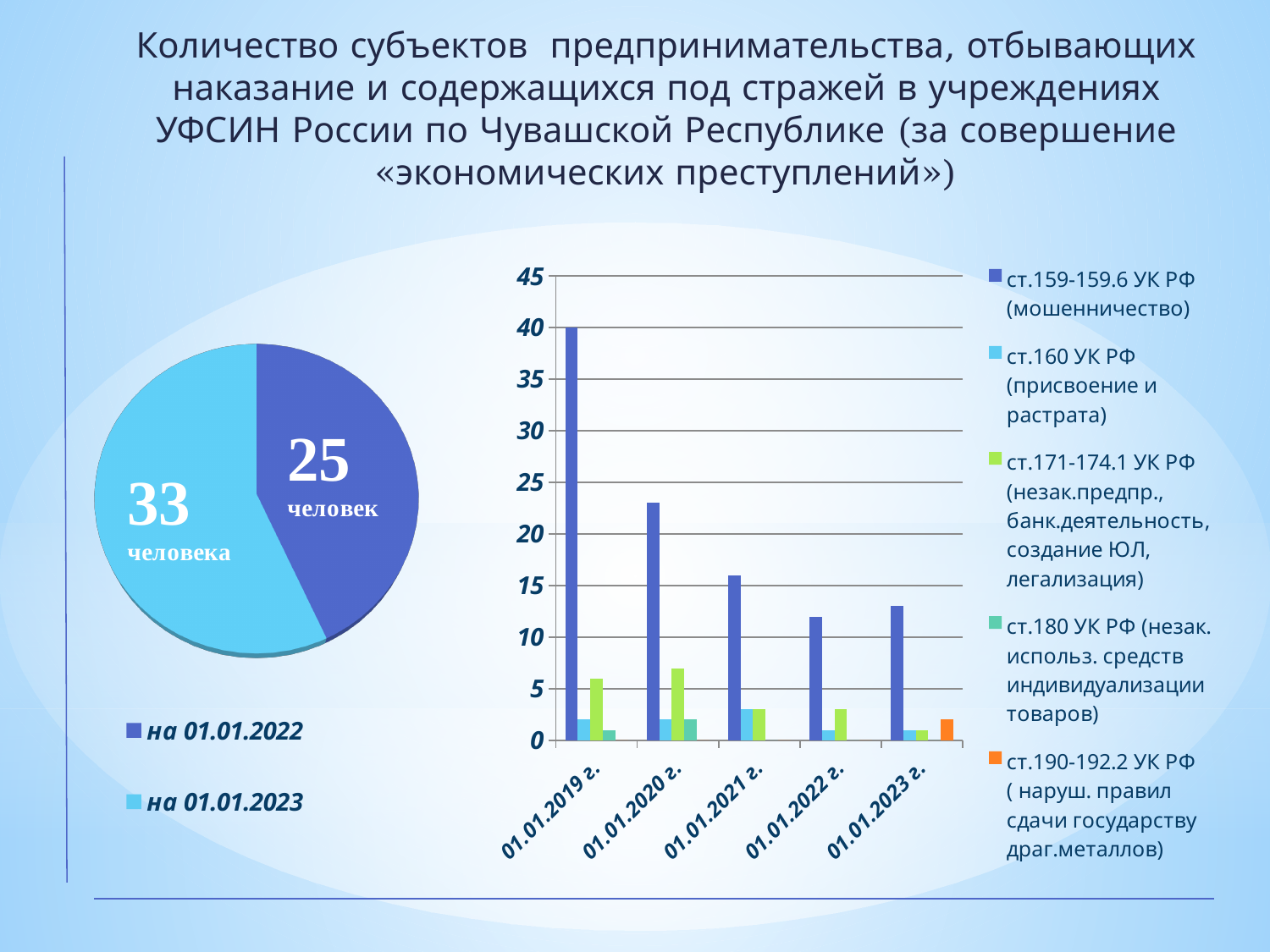
How many date categories are shown on the x axis of the bar chart on the right? 5 What kind of chart is the chart on the left side of the slide? pie chart In the pie chart on the left, what value is shown for the slice 'на 01.01.2022'? 25 человек In the bar chart on the right, is the value for 'ст.159-159.6 УК РФ (мошенничество)' at 01.01.2021 г. greater or less than 20? less How many slices does the pie chart on the left have? 2 What kind of chart is the chart on the right side of the slide? bar chart In the bar chart on the right, for which date is the value of 'ст.159-159.6 УК РФ (мошенничество)' the highest? 01.01.2019 г. In the pie chart on the left, what value is shown for the slice 'на 01.01.2023'? 33 человека How many series does the legend of the bar chart on the right list? 5 In the pie chart on the left, what is the difference between the values for 'на 01.01.2023' and 'на 01.01.2022'? 8 In the bar chart on the right, is the value for 'ст.159-159.6 УК РФ (мошенничество)' at 01.01.2019 г. greater or less than 35? greater In the pie chart on the left, which slice is larger: 'на 01.01.2022' or 'на 01.01.2023'? на 01.01.2023